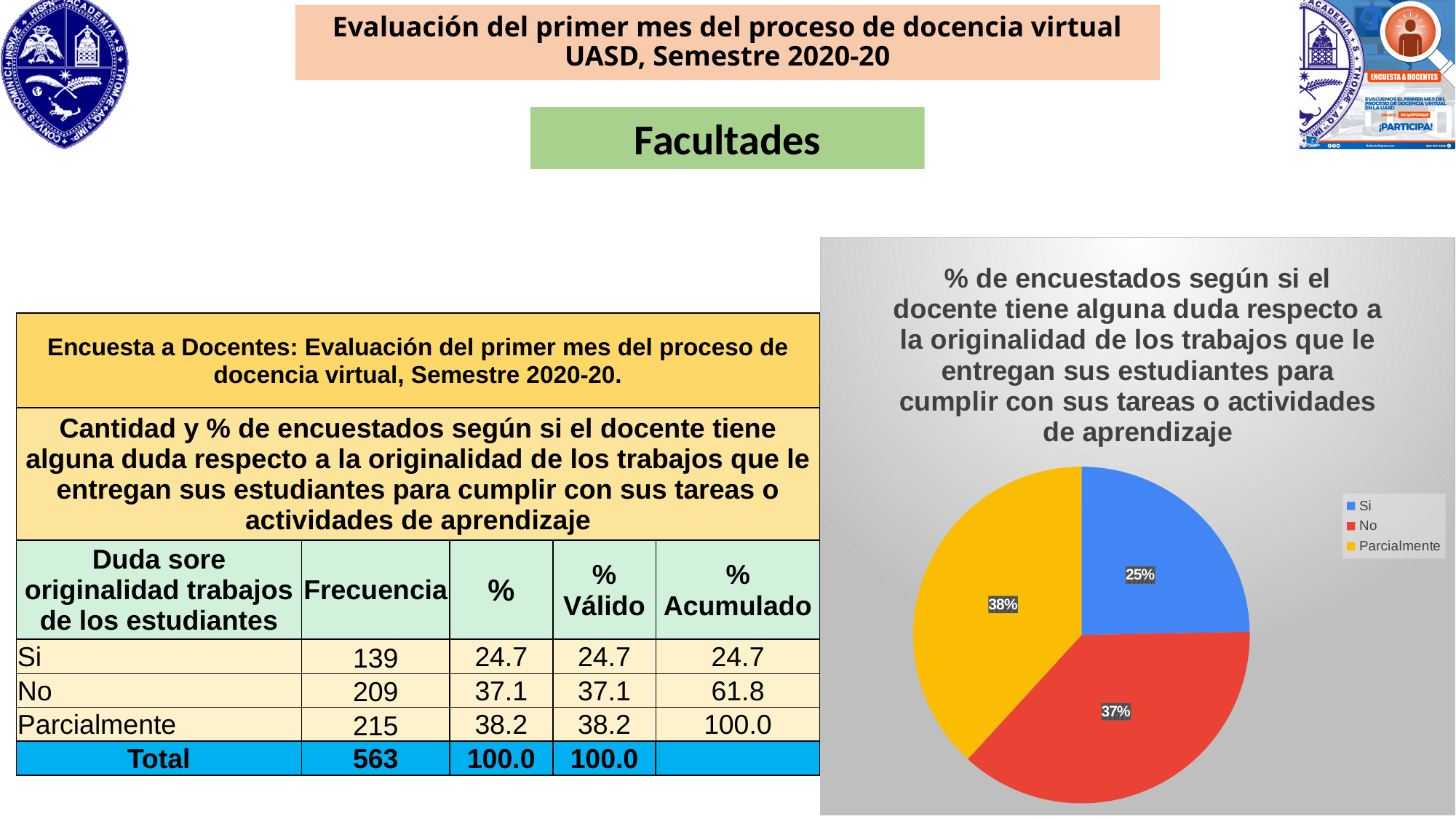
Which category has the largest slice in the pie chart? Parcialmente What colour is the 'Parcialmente' slice in the pie chart? yellow Which slice is larger in the pie chart, 'Si' or 'No'? No What type of chart is shown on the slide? pie chart What percentage of the pie chart corresponds to 'Si'? 25% What percentage of the pie chart corresponds to 'Parcialmente'? 38% How many entries does the legend of the pie chart list? 3 What colour is the 'No' slice in the pie chart? red How many slices does the pie chart have? 3 What percentage of the pie chart corresponds to 'No'? 37% Which category has the smallest slice in the pie chart? Si What is the difference in percentage points between the 'Parcialmente' slice and the 'Si' slice? 13